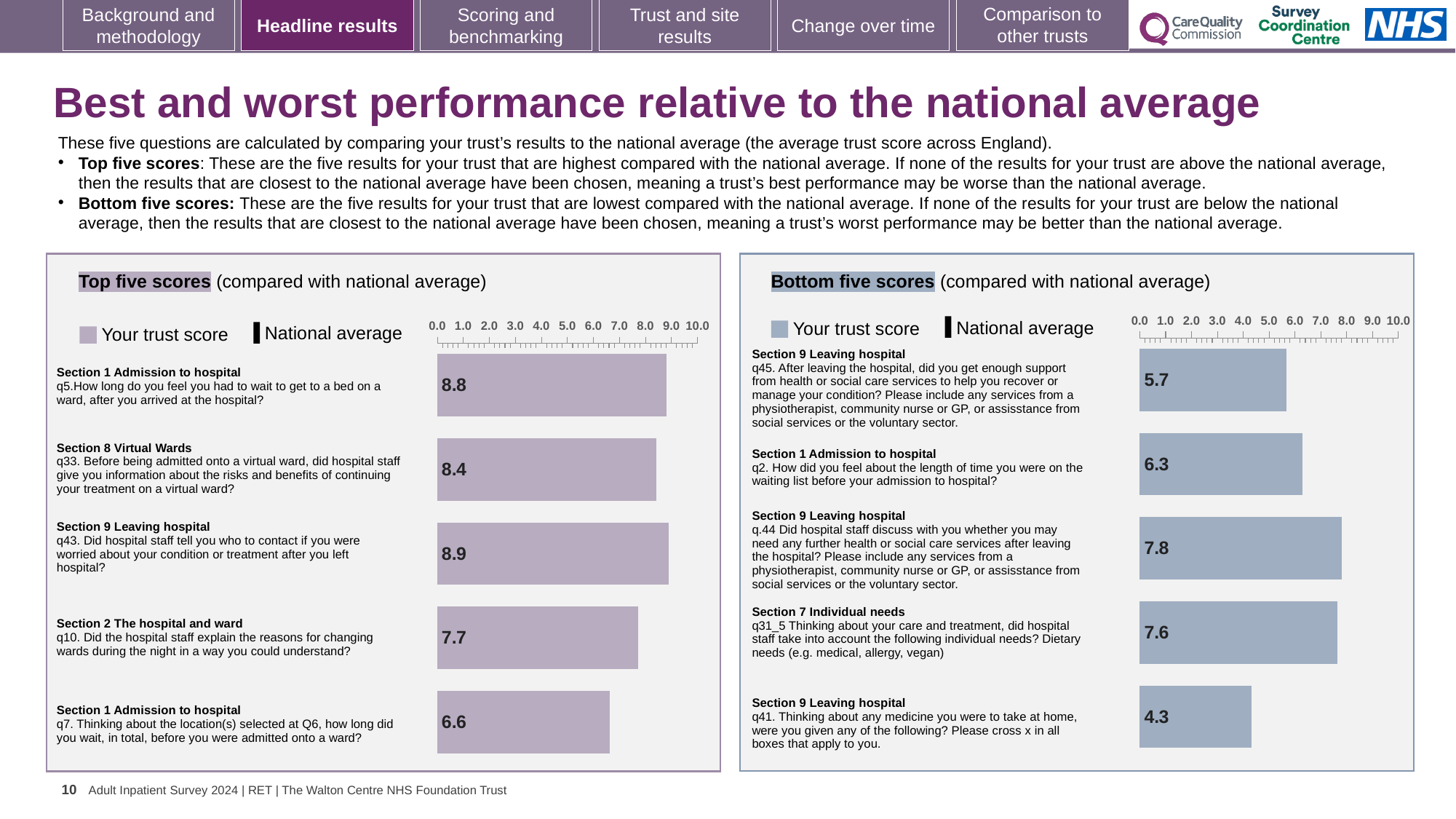
In the Bottom five scores chart, which question has the highest trust score? q44 (discussing further health or social care services after leaving hospital) In the Bottom five scores chart, which is larger: the trust score for q2 or for q31_5? q31_5 In the Bottom five scores chart, what is the trust score for q41 (medicine to take at home)? 4.3 In the Top five scores chart, what is the trust score for q33 (information about risks and benefits of a virtual ward)? 8.4 In the Bottom five scores chart, what is the trust score for q45 (support from health or social care services after leaving hospital)? 5.7 In the Top five scores chart, which question has the lowest trust score? q7 (how long you waited before being admitted onto a ward) In the Bottom five scores chart, what is the difference between the trust scores for q44 and q31_5? 0.2 What type of chart is used in the Bottom five scores panel? Bar chart In the Top five scores chart, what is the difference between the trust scores for q43 and q7? 2.3 In the Top five scores chart, what is the trust score for q5 (how long you had to wait to get to a bed on a ward)? 8.8 How many bars are plotted in the Top five scores chart? 5 In the Top five scores chart, which question has the highest trust score? q43 (who to contact if worried after leaving hospital)